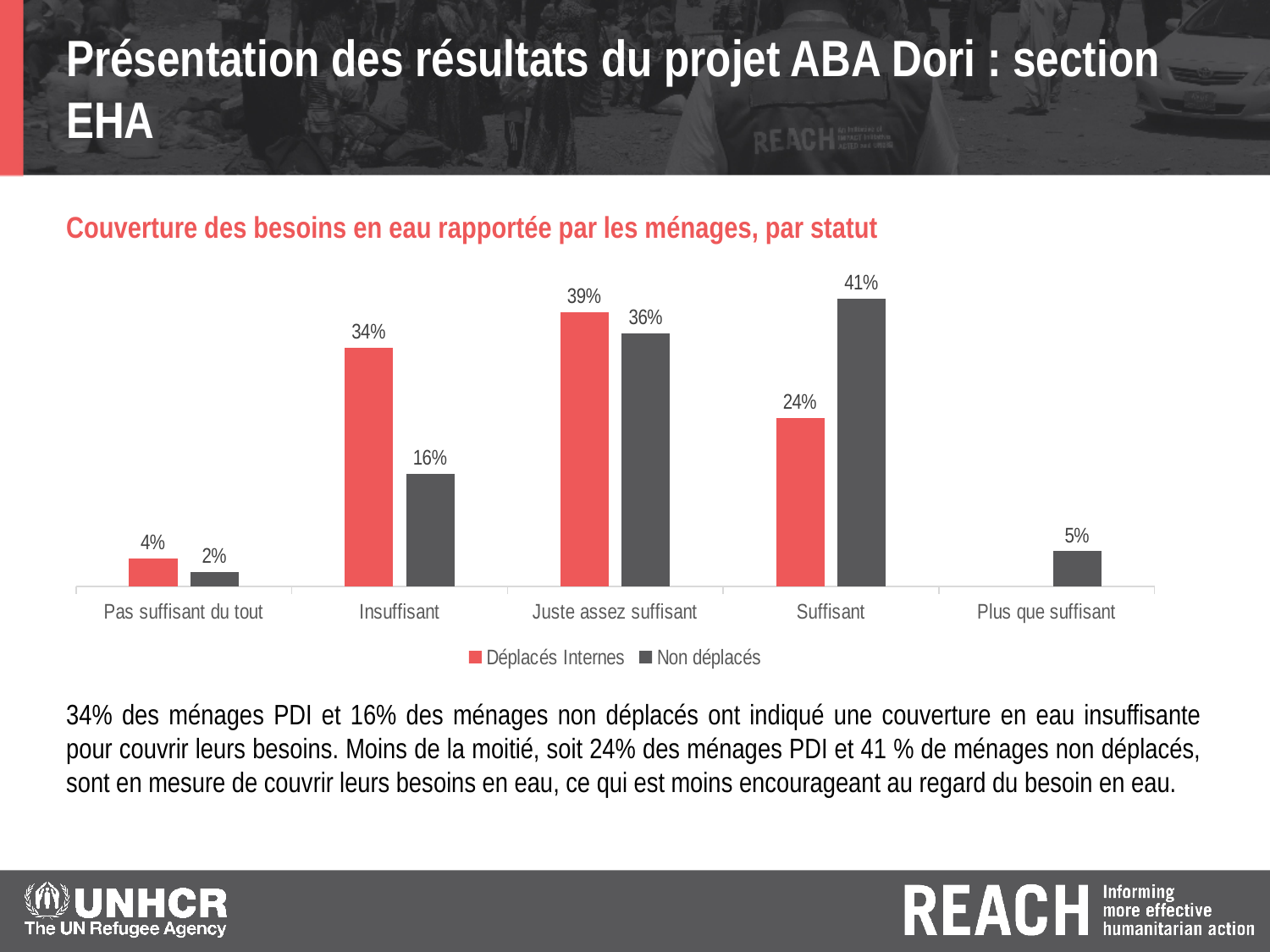
Which category has the highest value for Déplacés Internes? Juste assez suffisant What is the value for Déplacés Internes in the Insuffisant category? 34% What is the value for Non déplacés in the Plus que suffisant category? 5% What is the title of the chart? Couverture des besoins en eau rapportée par les ménages, par statut What is the difference between Non déplacés and Déplacés Internes in the Suffisant category? 17% How many categories are shown on the x axis? 5 What kind of chart is shown on the slide? Bar chart What is the difference between Déplacés Internes and Non déplacés in the Insuffisant category? 18% Which category has the lowest value for Non déplacés? Pas suffisant du tout How many series does the legend list? 2 What is the value for Non déplacés in the Suffisant category? 41% Which series has the larger value in the Juste assez suffisant category? Déplacés Internes